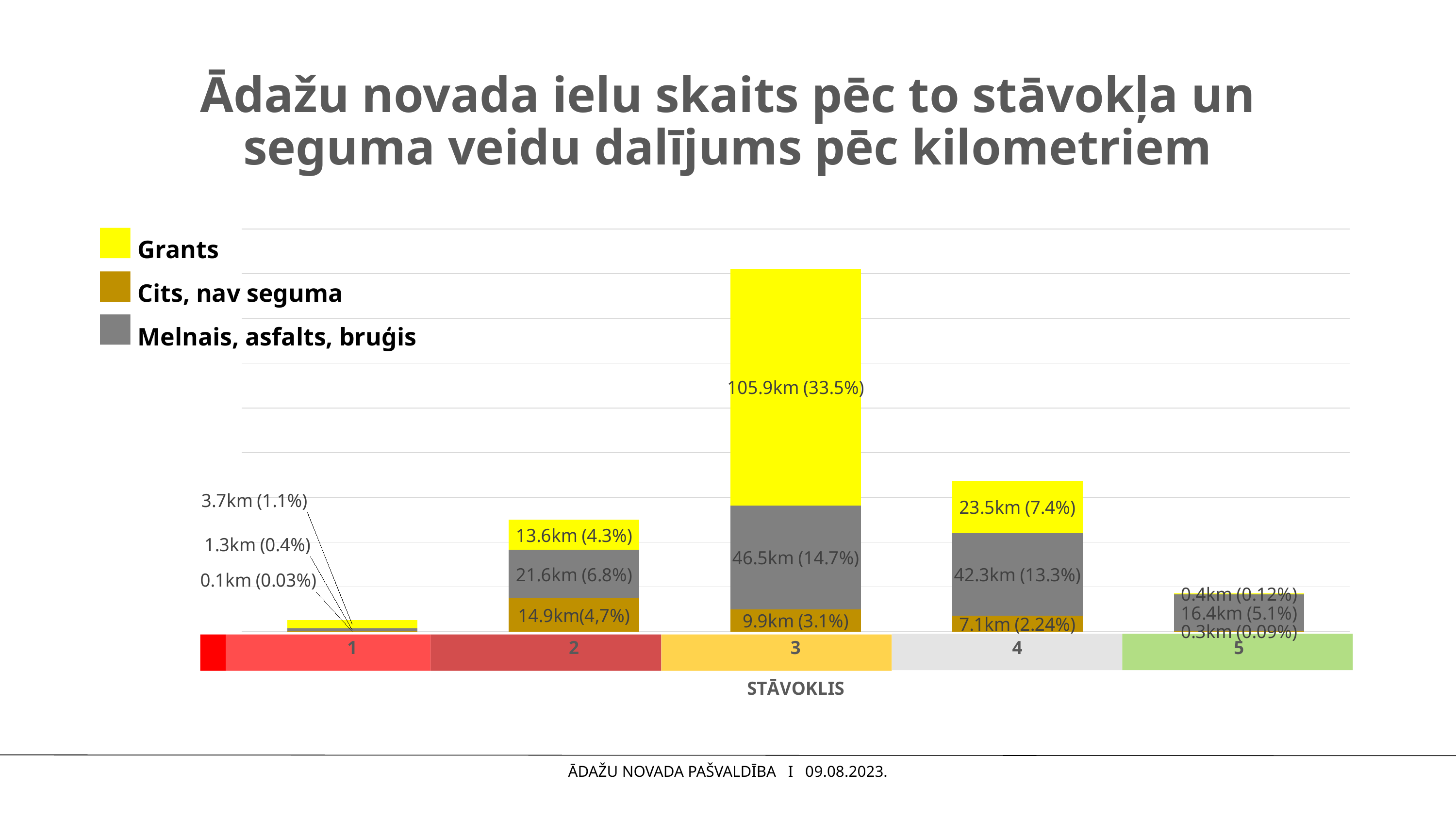
What is the value of Grants for category 3? 105.9km (33.5%) What kind of chart is shown on the slide? stacked bar chart Which category has the highest total stacked bar? 3 Which category has the lowest total stacked bar? 1 How many series does the legend list? 3 What is the value of Cits, nav seguma for category 2? 14.9km(4,7%) What is the value of Melnais, asfalts, bruģis for category 4? 42.3km (13.3%) What is the total length in kilometres of the stacked bar for category 3? 162.3km How many categories are shown on the x axis (STĀVOKLIS)? 5 Which is larger for category 2: Grants or Melnais, asfalts, bruģis? Melnais, asfalts, bruģis What is the value of Melnais, asfalts, bruģis for category 5? 16.4km (5.1%) What is the difference in kilometres between Grants for category 3 and Grants for category 4? 82.4km